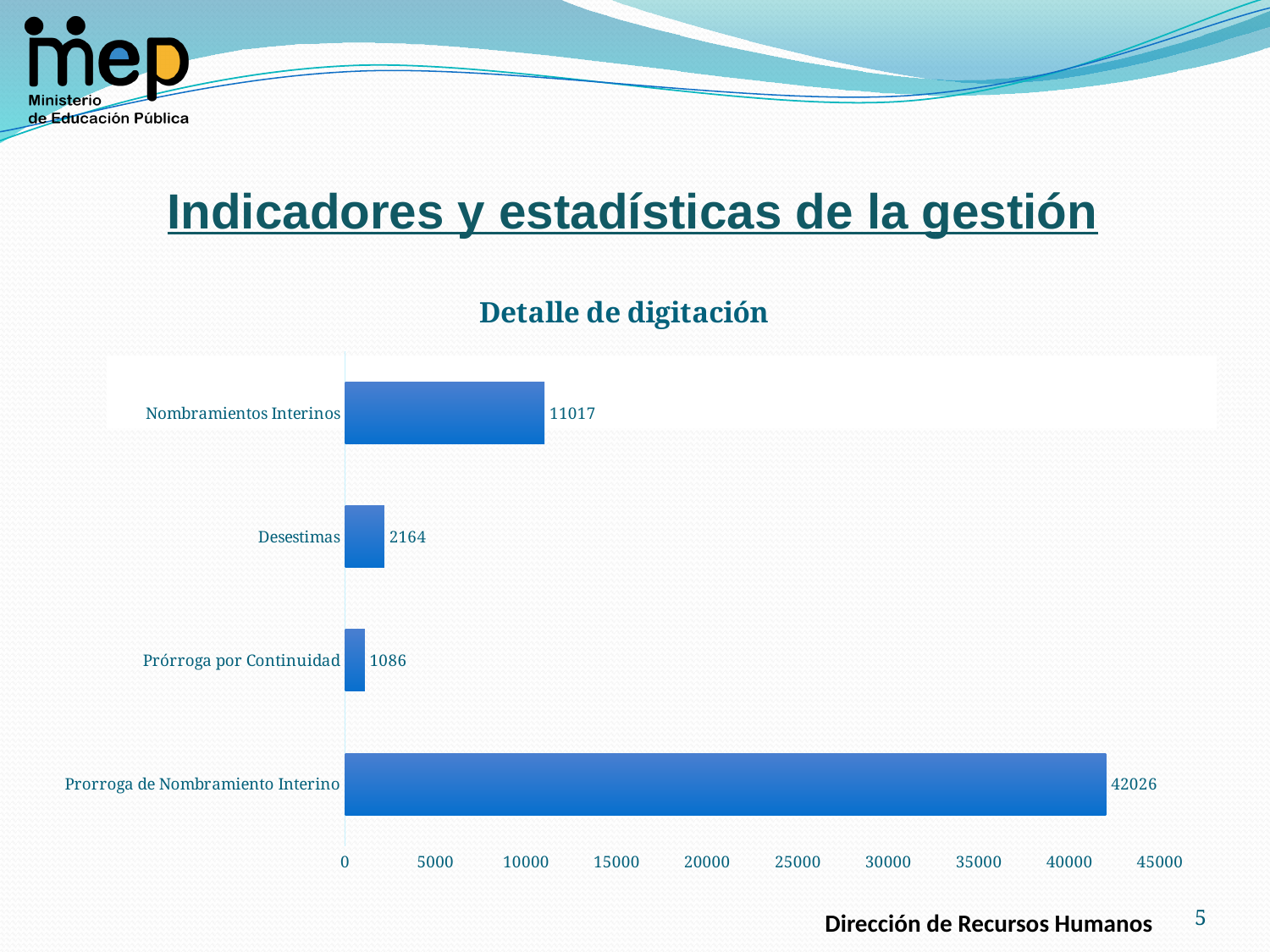
What is the value for Nombramientos Interinos? 11017 Which is larger, Nombramientos Interinos or Desestimas? Nombramientos Interinos What is the difference between Desestimas and Prórroga por Continuidad? 1078 Which category has the lowest value? Prórroga por Continuidad What is the value for Prorroga de Nombramiento Interino? 42026 What is the value for Prórroga por Continuidad? 1086 How many categories are shown in the chart? 4 What type of chart is shown? Bar chart Is the value for Nombramientos Interinos greater or less than 10000? greater What is the difference between Prorroga de Nombramiento Interino and Nombramientos Interinos? 31009 Which category has the highest value? Prorroga de Nombramiento Interino What is the value for Desestimas? 2164